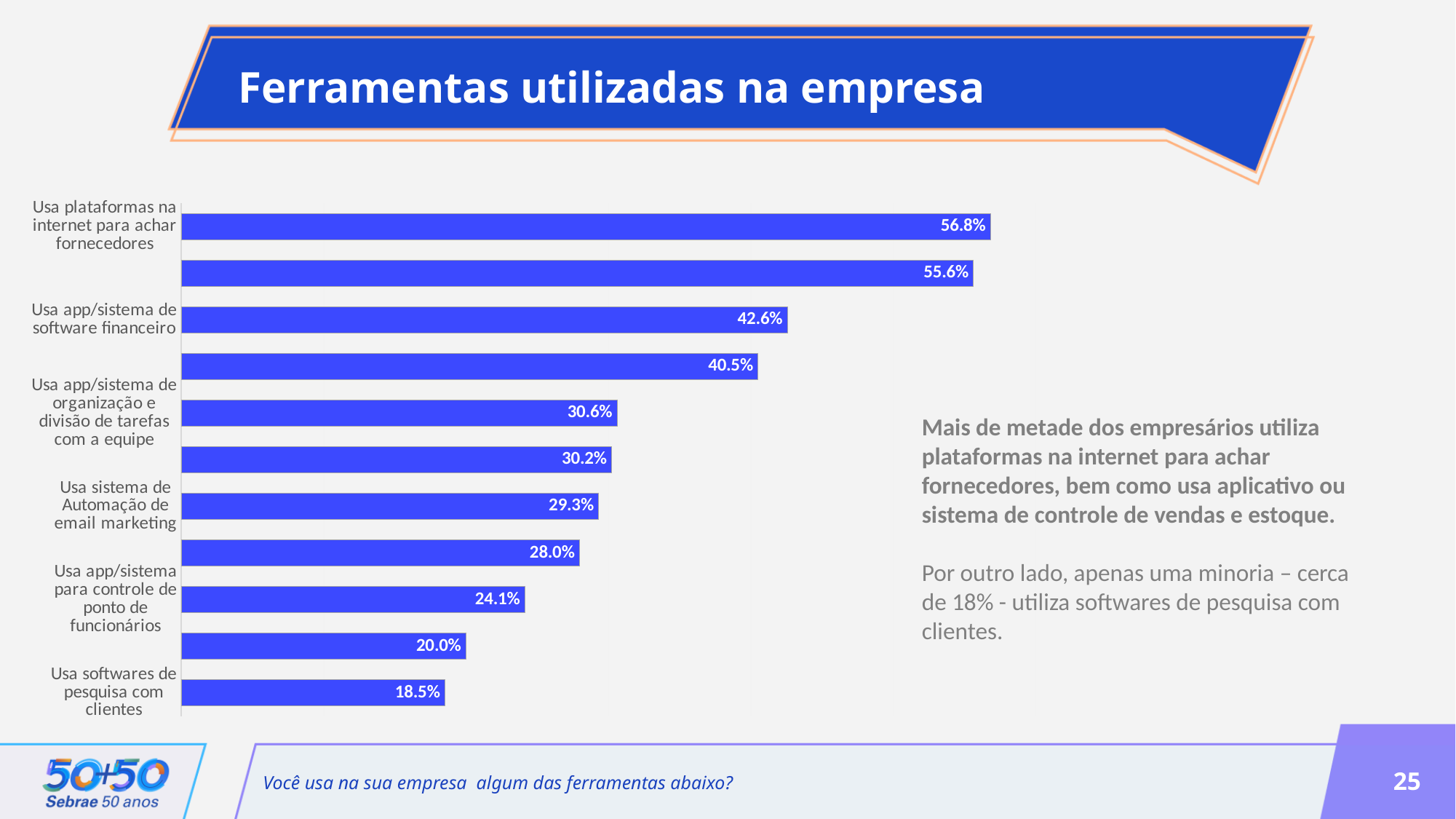
Which category has the lowest value? Usa softwares de pesquisa com clientes What is the difference between the values for "Usa plataformas na internet para achar fornecedores" and "Usa softwares de pesquisa com clientes"? 38.3% What is the value for "Usa app/sistema para controle de ponto de funcionários"? 24.1% What is the value for "Usa plataformas na internet para achar fornecedores"? 56.8% How many bars are plotted in the chart? 11 What is the value for "Usa softwares de pesquisa com clientes"? 18.5% What kind of chart is shown on the slide? Bar chart What is the title of the slide containing the chart? Ferramentas utilizadas na empresa Which is larger: the value for "Usa app/sistema de software financeiro" or for "Usa app/sistema de organização e divisão de tarefas com a equipe"? Usa app/sistema de software financeiro Which category has the highest value? Usa plataformas na internet para achar fornecedores What is the value for "Usa app/sistema de software financeiro"? 42.6% What is the value for "Usa sistema de Automação de email marketing"? 29.3%